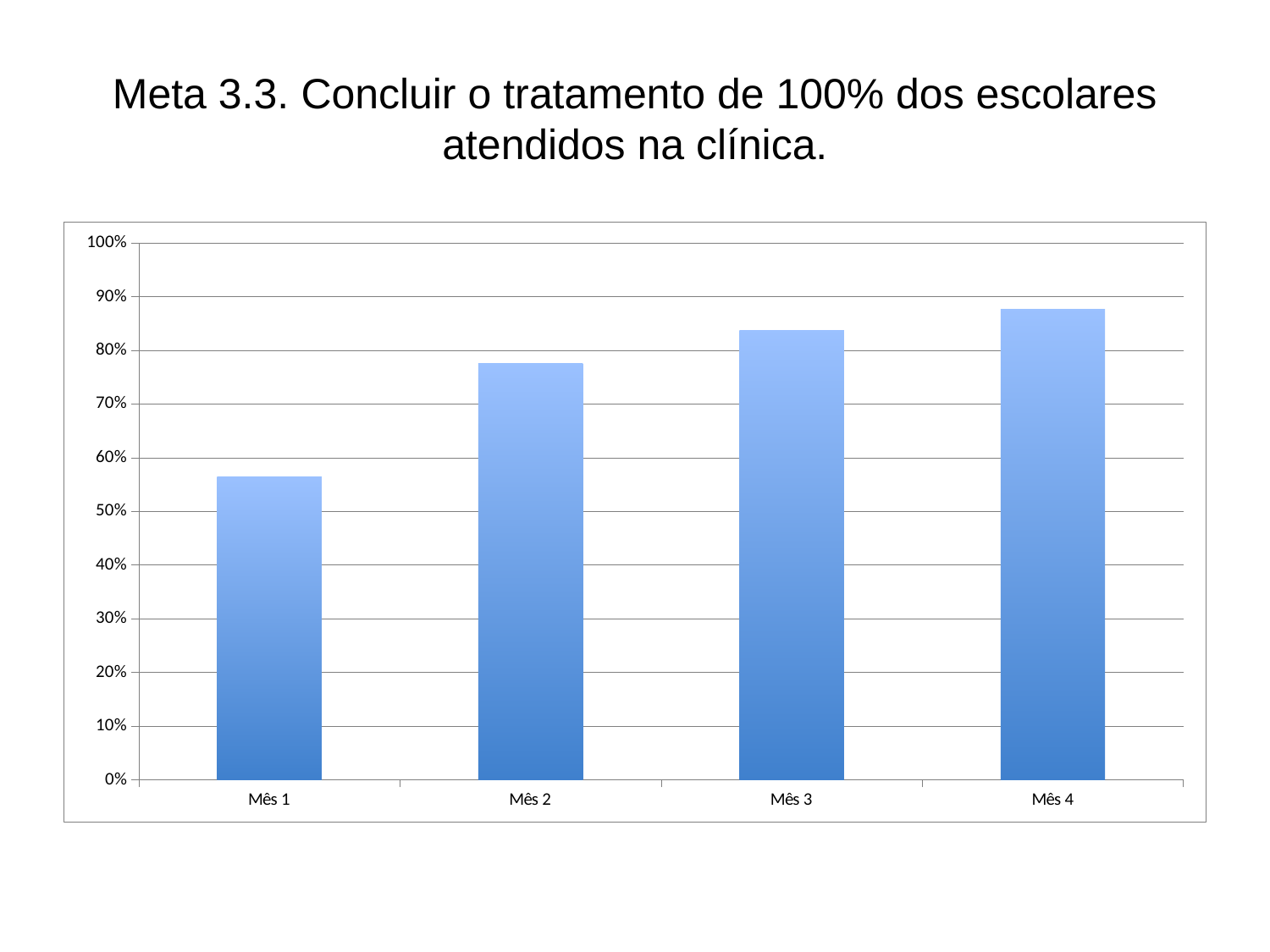
What kind of chart is shown on the slide? bar chart How many months (categories) are plotted on the chart? 4 Is the value for Mês 1 greater or less than 60%? less Is the value for Mês 1 greater or less than 50%? greater Which month has the highest bar? Mês 4 Is the value for Mês 2 greater or less than 70%? greater Which month has the lowest bar? Mês 1 Which is larger, the value for Mês 1 or the value for Mês 2? Mês 2 Do the values rise or fall from Mês 1 to Mês 4? rise